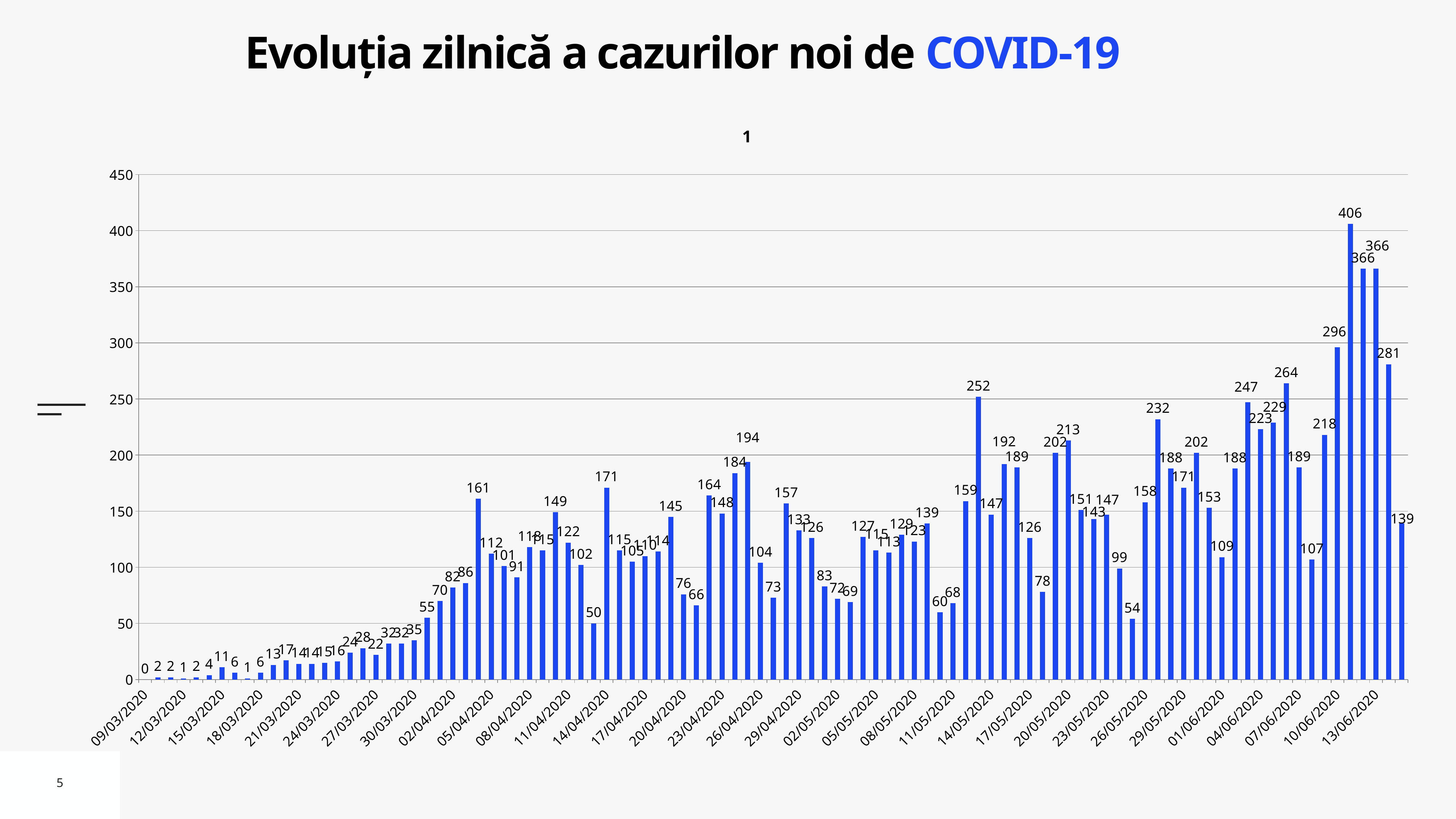
What is the title of the slide? Evoluția zilnică a cazurilor noi de COVID-19 What is the value for 12/03/2020? 1 How many bars have a value above 400? 1 Do the daily values generally rise or fall from March to June along the x axis? rise How many bars have a value above 350? 3 What is the value for 14/05/2020? 147 What is the difference between the highest bar (406) and the next highest value (366)? 40 What kind of chart is shown on the slide? bar chart What is the highest daily value shown in the chart? 406 What is the lowest daily value shown in the chart? 0 Which is larger, the value for 14/05/2020 or the value for 11/04/2020? 14/05/2020 What is the value for 09/03/2020? 0